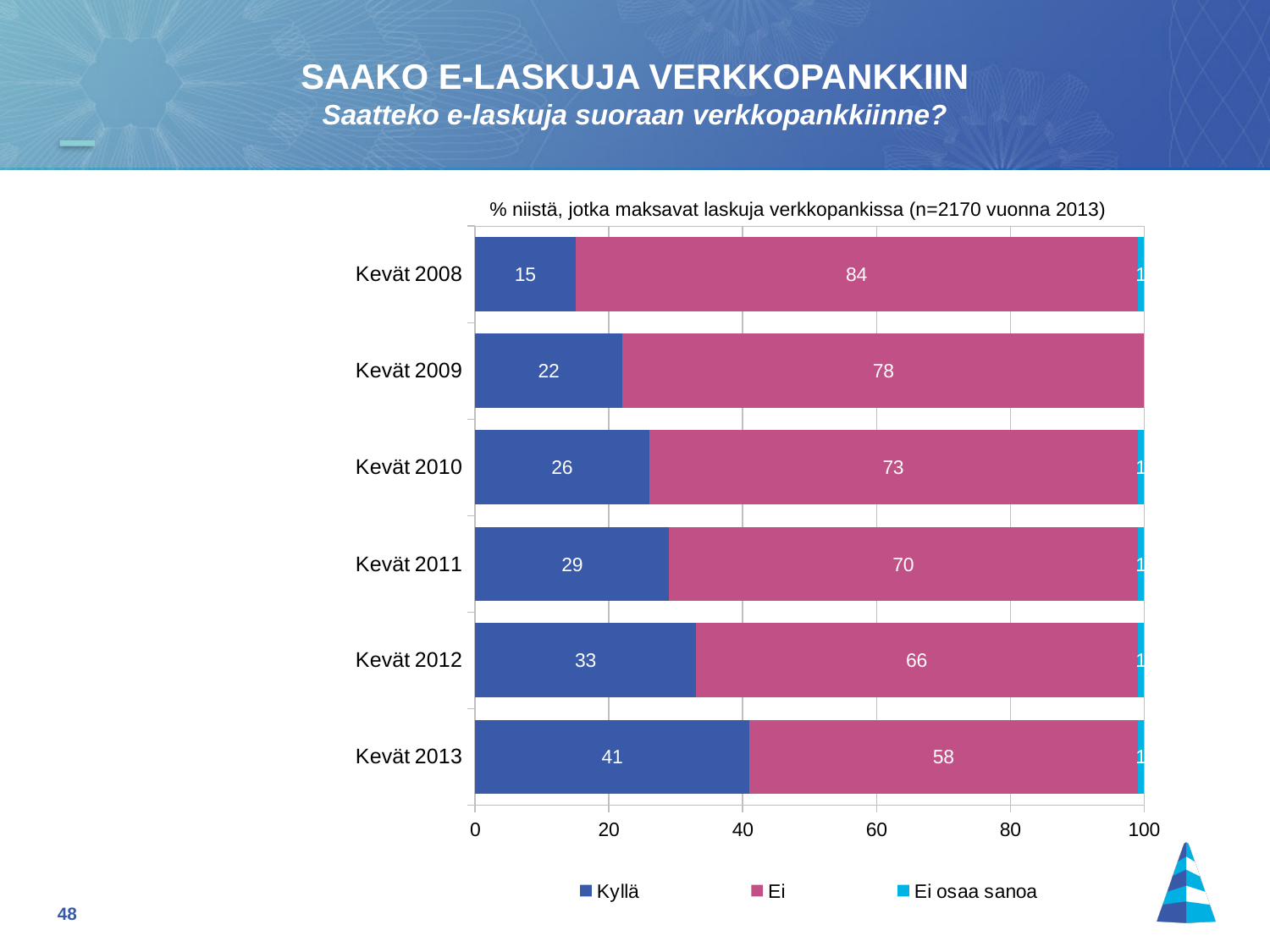
Which is larger for Kevät 2011: the Kyllä value or the Ei value? Ei Which survey round has the lowest Ei value? Kevät 2013 What is the Ei value for Kevät 2008? 84 How many categories (survey rounds) are shown on the chart? 6 Does the Kyllä value rise or fall from Kevät 2008 to Kevät 2013? rise What type of chart is shown on the slide? stacked bar chart What is the Kyllä value for Kevät 2010? 26 What is the total of the stacked bar for Kevät 2013? 100 Which survey round has the highest Kyllä value? Kevät 2013 How many series does the legend list? 3 What is the Kyllä value for Kevät 2013? 41 What is the difference between the Ei value and the Kyllä value for Kevät 2012? 33